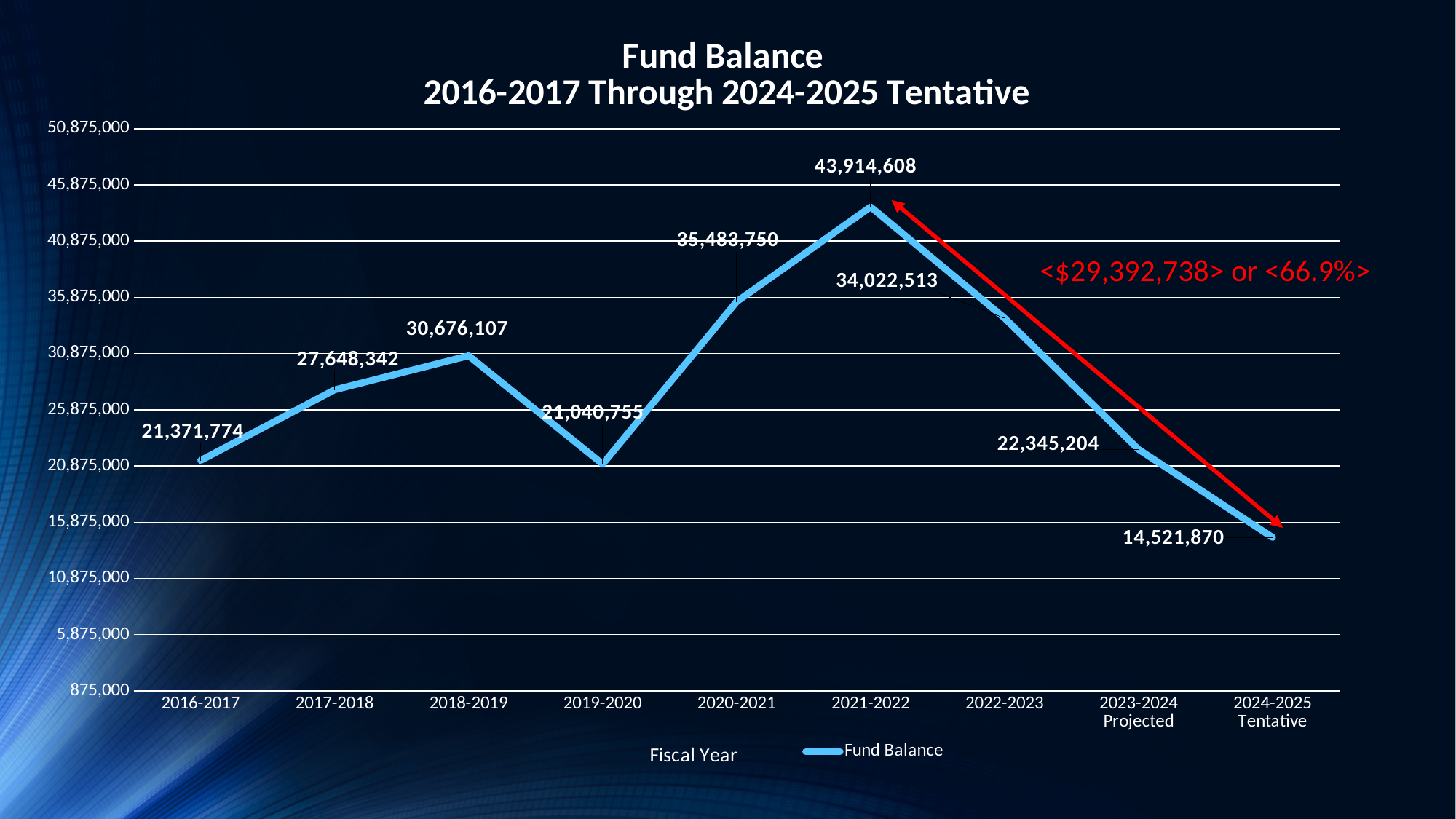
How many fiscal years are plotted on the chart? 9 What is the fund balance for 2021-2022? 43,914,608 What is the fund balance for 2019-2020? 21,040,755 Which is larger, the fund balance for 2020-2021 or for 2022-2023? 2020-2021 What is the difference between the fund balance in 2021-2022 and in 2024-2025 Tentative? 29,392,738 What is the fund balance for 2024-2025 Tentative? 14,521,870 Which fiscal year has the lowest fund balance? 2024-2025 Tentative What kind of chart is shown on the slide? Line chart What is the difference between the fund balance in 2018-2019 and in 2017-2018? 3,027,765 What is the fund balance for 2023-2024 Projected? 22,345,204 Does the fund balance rise or fall from 2021-2022 to 2024-2025 Tentative? Fall Which fiscal year has the highest fund balance? 2021-2022